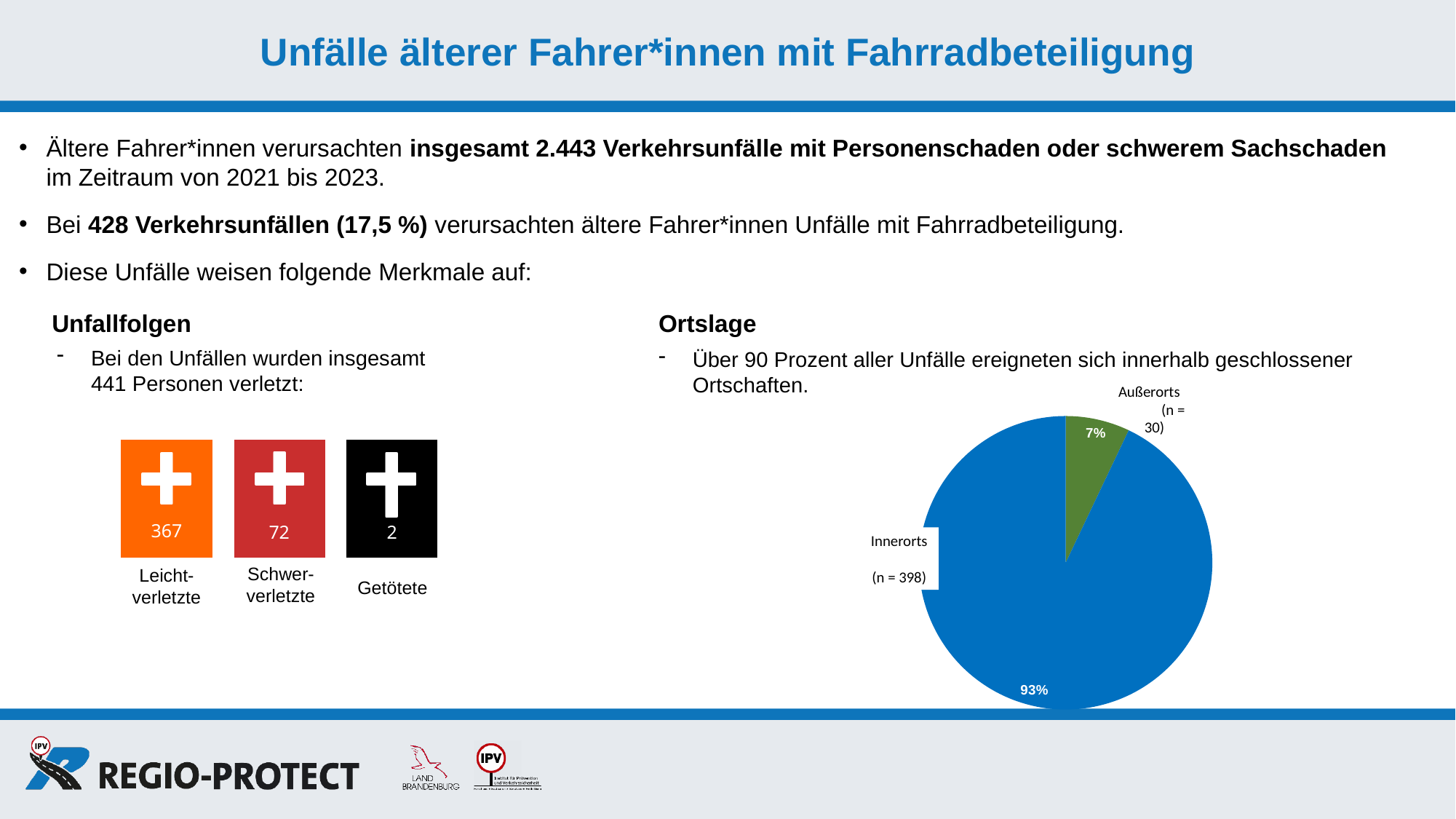
In the pie chart, which has more accidents, Innerorts or Außerorts? Innerorts In the pie chart, what share of accidents is labelled for Innerorts? 93% Which slice of the pie chart is the largest? Innerorts In the pie chart, what is the n value given for Innerorts? 398 In the pie chart, what is the difference between the n values for Innerorts and Außerorts? 368 How many slices does the pie chart have? 2 What kind of chart is shown under the heading "Ortslage"? pie chart In the pie chart, what is the n value given for Außerorts? 30 In the pie chart, what is the total of the n values for Innerorts and Außerorts? 428 Which slice of the pie chart is the smallest? Außerorts What colour is the Außerorts slice in the pie chart? green In the pie chart, what share of accidents is labelled for Außerorts? 7%